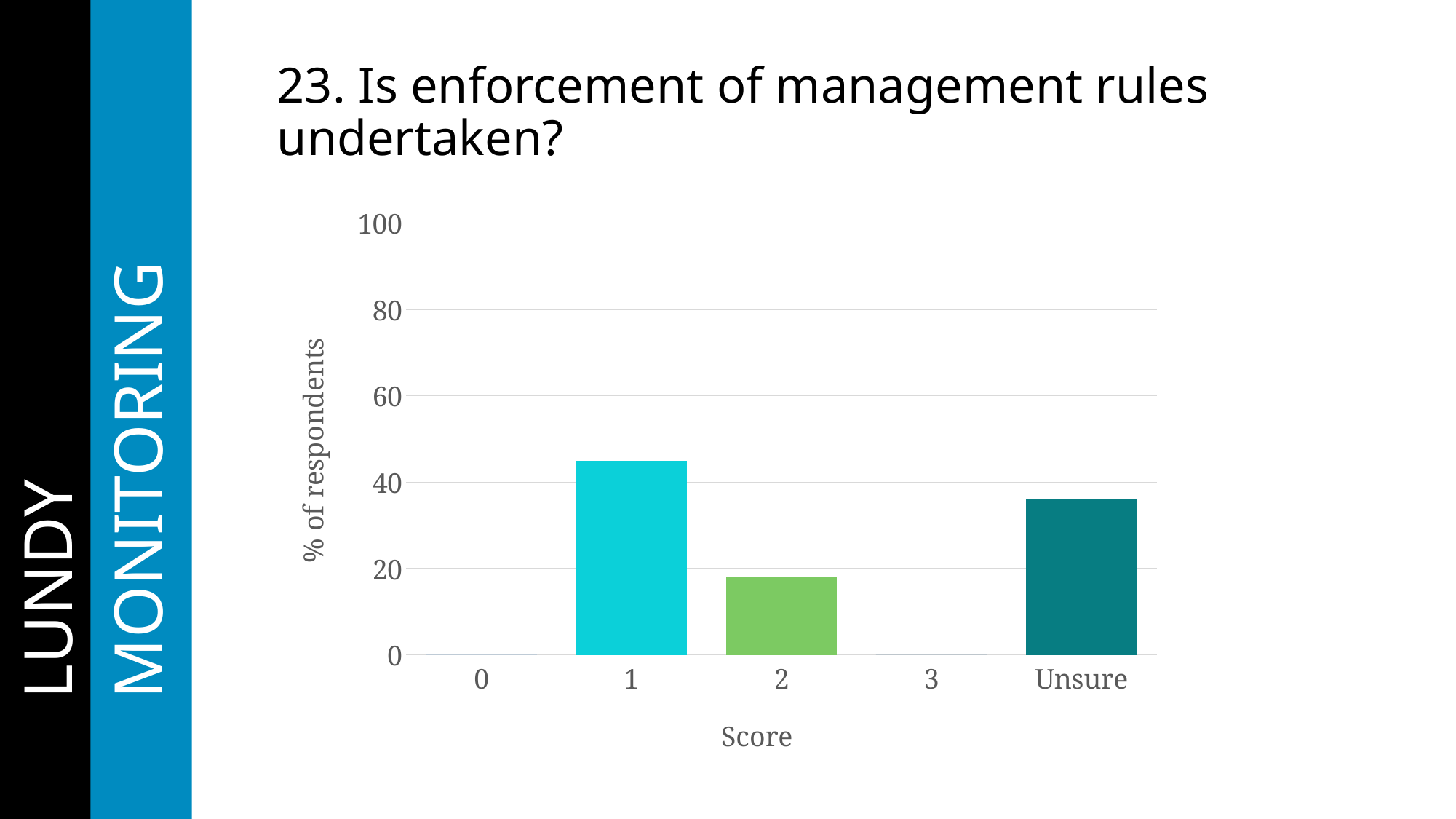
What is the percentage of respondents for score 3? 0 Is the value for Unsure greater or less than 40? less What kind of chart is shown on the slide? bar chart Which score category has the highest percentage of respondents? 1 Which has a higher percentage of respondents, score 2 or Unsure? Unsure Is the value for Unsure greater or less than 20? greater Is the value for score 1 greater or less than 40? greater How many score categories are shown on the x axis? 5 What is the label of the x axis? Score What is the label of the y axis? % of respondents Which has a higher percentage of respondents, score 1 or Unsure? 1